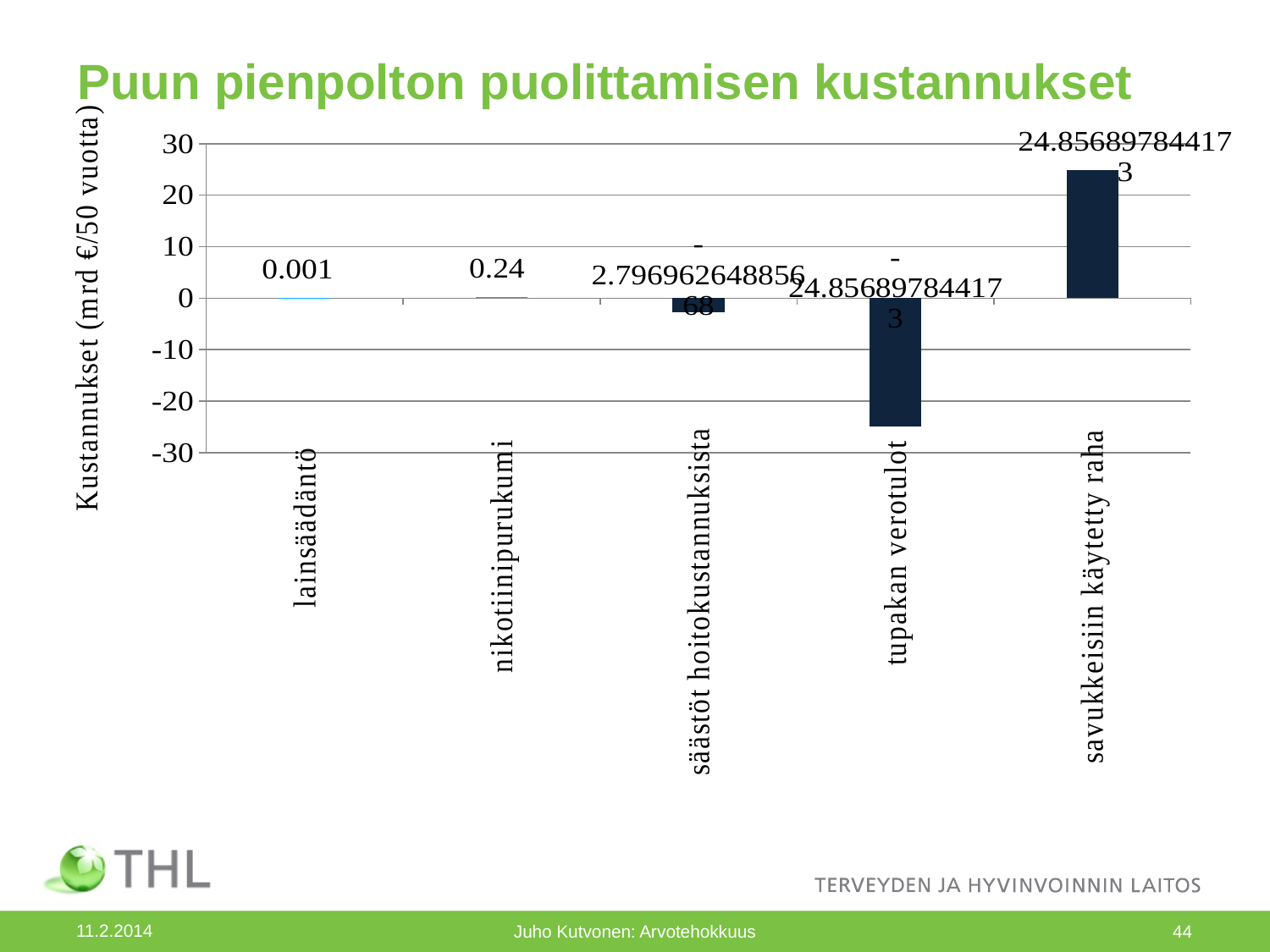
What type of chart is shown on the slide? bar chart What is the value for nikotiinipurukumi? 0.24 Which is larger, the value for lainsäädäntö or the value for nikotiinipurukumi? nikotiinipurukumi Which category has the lowest value? tupakan verotulot What is the difference between the value for nikotiinipurukumi and the value for lainsäädäntö? 0.239 What is the title of the chart? Puun pienpolton puolittamisen kustannukset Is the value for savukkeisiin käytetty raha greater or less than 20? greater Which category has the highest value? savukkeisiin käytetty raha Is the value for tupakan verotulot greater or less than -20? less How many categories are shown on the x axis? 5 What is the label of the vertical axis? Kustannukset (mrd €/50 vuotta) What is the value for lainsäädäntö? 0.001